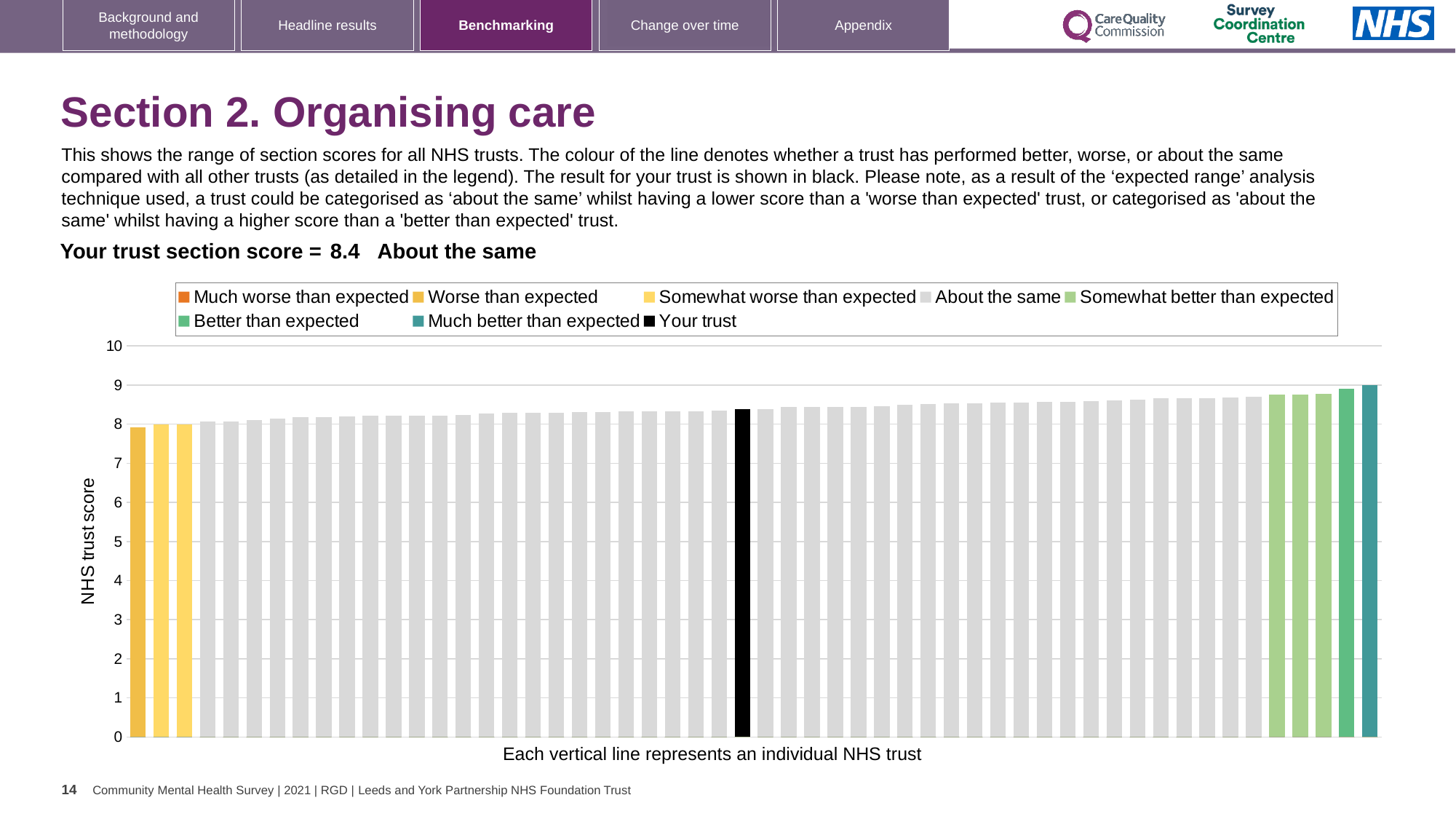
Is the value of the tallest bar in the chart greater or less than 8? greater Which benchmarking category is your trust placed in for Section 2. Organising care? About the same Is the value of the lowest bar in the chart greater or less than 9? less Is the value for your trust greater or less than 9? less What kind of chart is shown on the slide? Bar chart How many entries does the chart legend list? 8 Do the bar values rise or fall from left to right along the x axis? rise What is the section score for your trust shown on the slide? 8.4 What is the label on the vertical axis of the chart? NHS trust score What colour is the bar representing your trust? Black